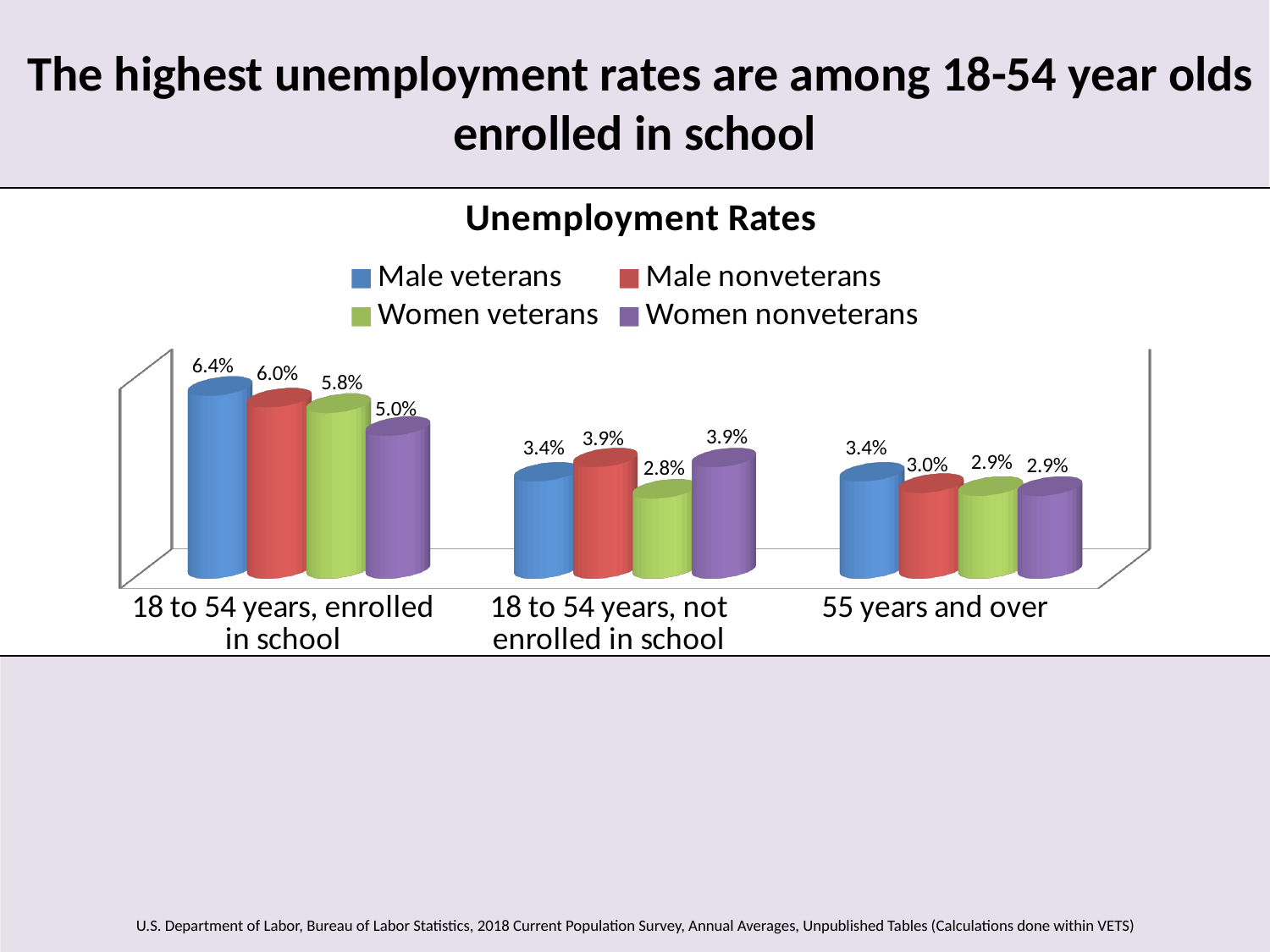
What is the unemployment rate for Women nonveterans aged 18 to 54 years, not enrolled in school? 3.9% How many series does the legend list? 4 What is the unemployment rate for Male veterans aged 18 to 54 years, enrolled in school? 6.4% What is the unemployment rate for Women veterans aged 18 to 54 years, not enrolled in school? 2.8% What is the difference between the Male veterans and Women nonveterans unemployment rates for 18 to 54 years, enrolled in school? 1.4% How many age categories are shown on the x axis? 3 Which series has the lowest unemployment rate in the 18 to 54 years, not enrolled in school category? Women veterans What kind of chart is shown on the slide? Bar chart Which is larger: the Male veterans rate for 55 years and over or the Male nonveterans rate for 55 years and over? Male veterans Which category has the highest unemployment rate for Male veterans? 18 to 54 years, enrolled in school What is the unemployment rate for Male nonveterans aged 55 years and over? 3.0% What is the title of the chart? Unemployment Rates